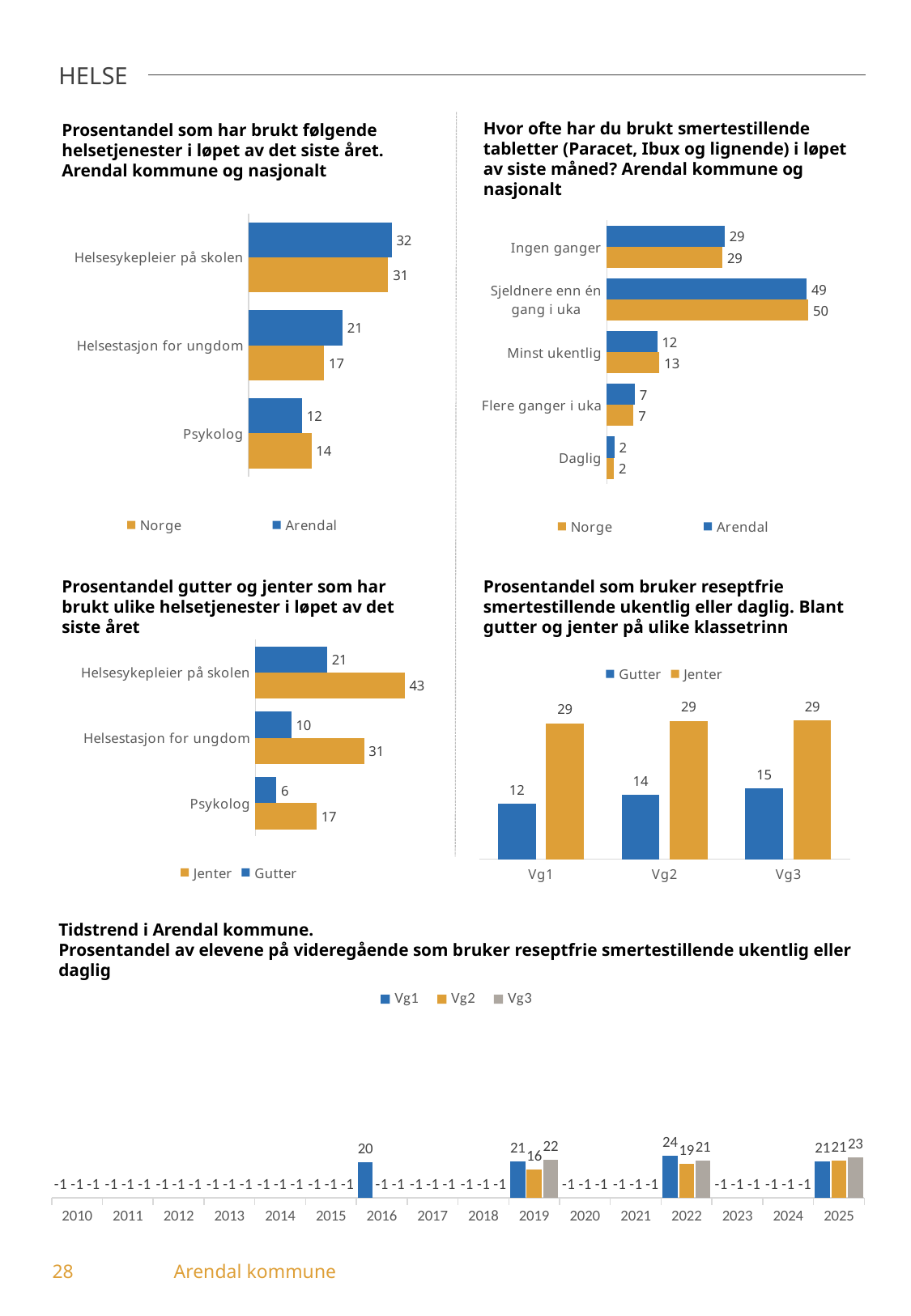
How many series does the legend list in the bottom chart 'Tidstrend i Arendal kommune'? 3 In the chart 'Prosentandel som bruker reseptfrie smertestillende ukentlig eller daglig', what is the Gutter value for Vg2? 14 In the chart 'Hvor ofte har du brukt smertestillende tabletter', what is the Norge value for Minst ukentlig? 13 In the chart 'Prosentandel gutter og jenter som har brukt ulike helsetjenester', what is the Jenter value for Helsesykepleier på skolen? 43 In the chart 'Prosentandel gutter og jenter som har brukt ulike helsetjenester', what is the difference between Jenter and Gutter for Helsestasjon for ungdom? 21 In the bottom chart 'Tidstrend i Arendal kommune', what is the Vg1 value for 2022? 24 In the chart 'Prosentandel som har brukt følgende helsetjenester i løpet av det siste året', what is the Arendal value for Helsesykepleier på skolen? 32 In the chart 'Prosentandel gutter og jenter som har brukt ulike helsetjenester', which category has the lowest value for Gutter? Psykolog In the chart 'Prosentandel som bruker reseptfrie smertestillende ukentlig eller daglig', is the Jenter value for Vg1 larger or smaller than the Gutter value for Vg1? larger In the chart 'Hvor ofte har du brukt smertestillende tabletter', which category has the highest value for Arendal? Sjeldnere enn én gang i uka In the chart 'Prosentandel som har brukt følgende helsetjenester i løpet av det siste året', what is the difference between the Arendal and Norge values for Helsestasjon for ungdom? 4 How many categories are shown in the chart 'Hvor ofte har du brukt smertestillende tabletter'? 5